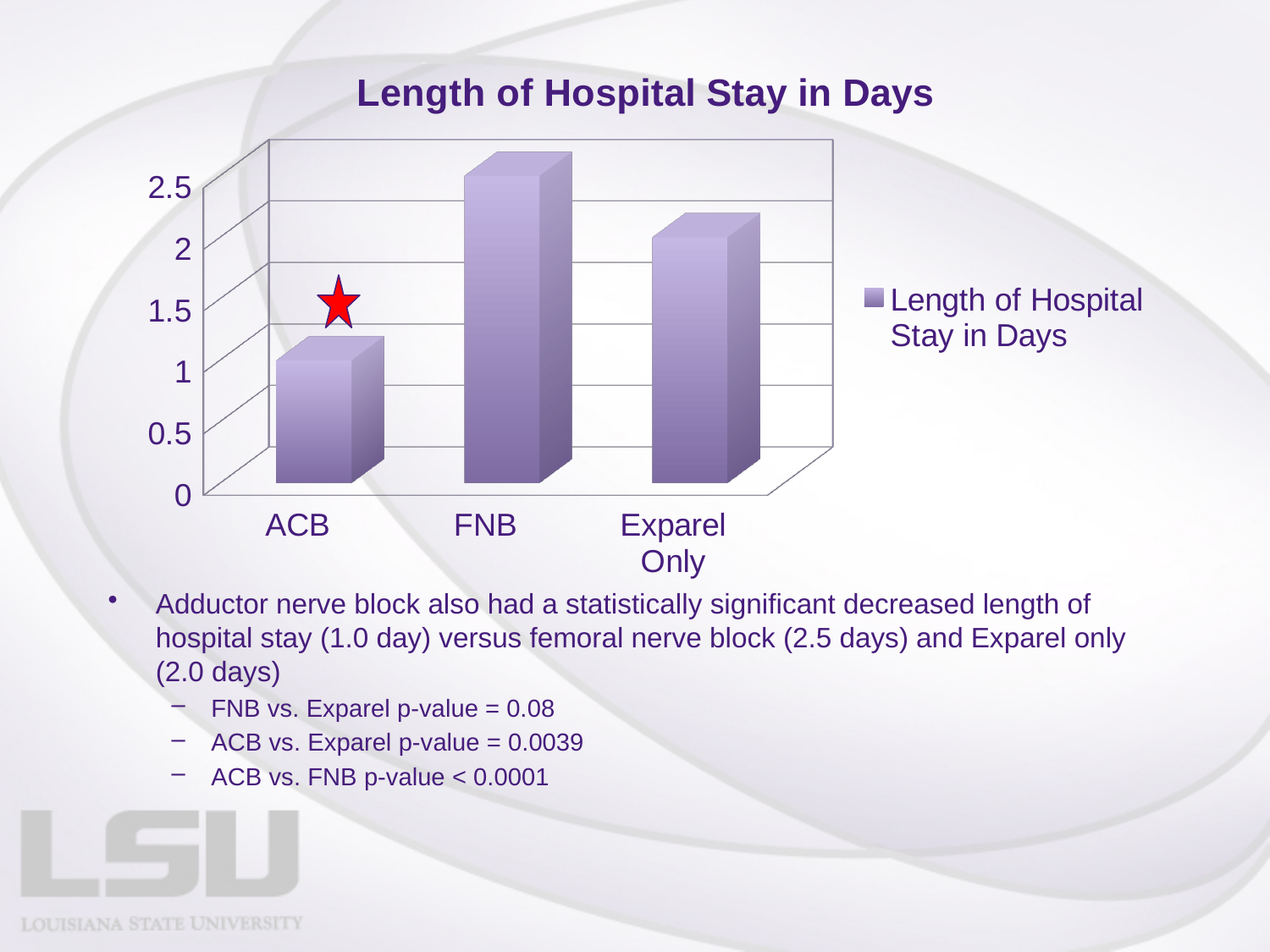
Is the value for ACB greater or less than 1.5? less Which category has the shortest length of hospital stay? ACB How many series does the chart legend list? 1 What is the difference in length of hospital stay between FNB and ACB? 1.5 days Which has a longer hospital stay, FNB or Exparel Only? FNB What type of chart is shown on the slide? Bar chart What is the length of hospital stay for FNB? 2.5 days How many categories are shown on the x axis of the chart? 3 What is the length of hospital stay for ACB? 1.0 day Which category has the longest length of hospital stay? FNB What is the title of the chart? Length of Hospital Stay in Days What is the length of hospital stay for Exparel Only? 2.0 days